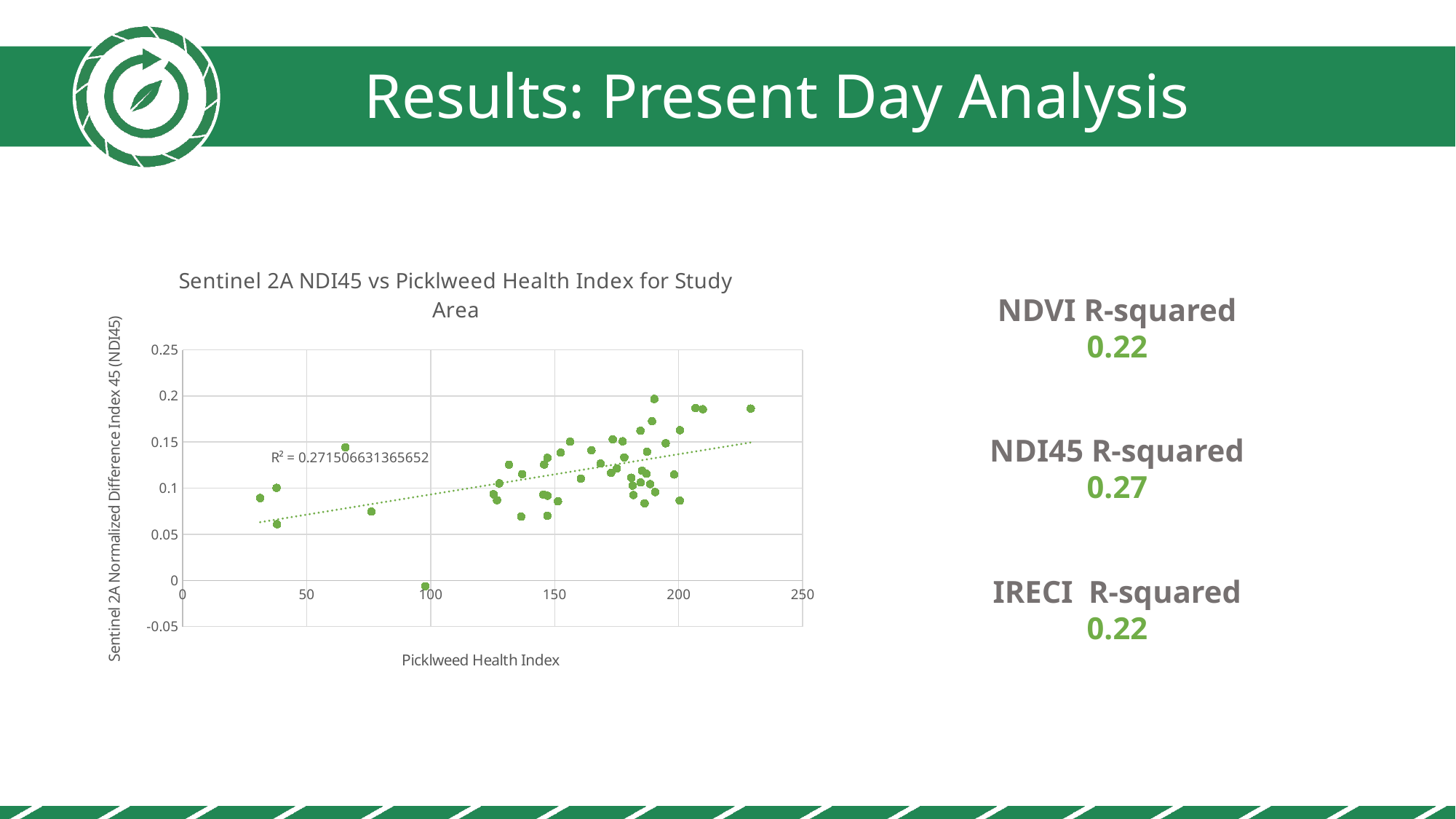
Is the NDI45 value of the point plotted at a Picklweed Health Index of about 230 greater or less than 0.15? greater What R-squared value is printed on the chart next to the trendline? R² = 0.271506631365652 Is the NDI45 value of the point plotted at a Picklweed Health Index of about 98 greater or less than 0.05? less What is the title of the chart? Sentinel 2A NDI45 vs Picklweed Health Index for Study Area Do the NDI45 values generally rise or fall as the Picklweed Health Index increases along the x axis? rise What is the maximum value shown on the y axis of the chart? 0.25 Is the NDI45 value of the point plotted at a Picklweed Health Index of about 65 greater or less than 0.1? greater What is the label of the x axis of the chart? Picklweed Health Index What kind of chart is shown on the slide? scatter chart